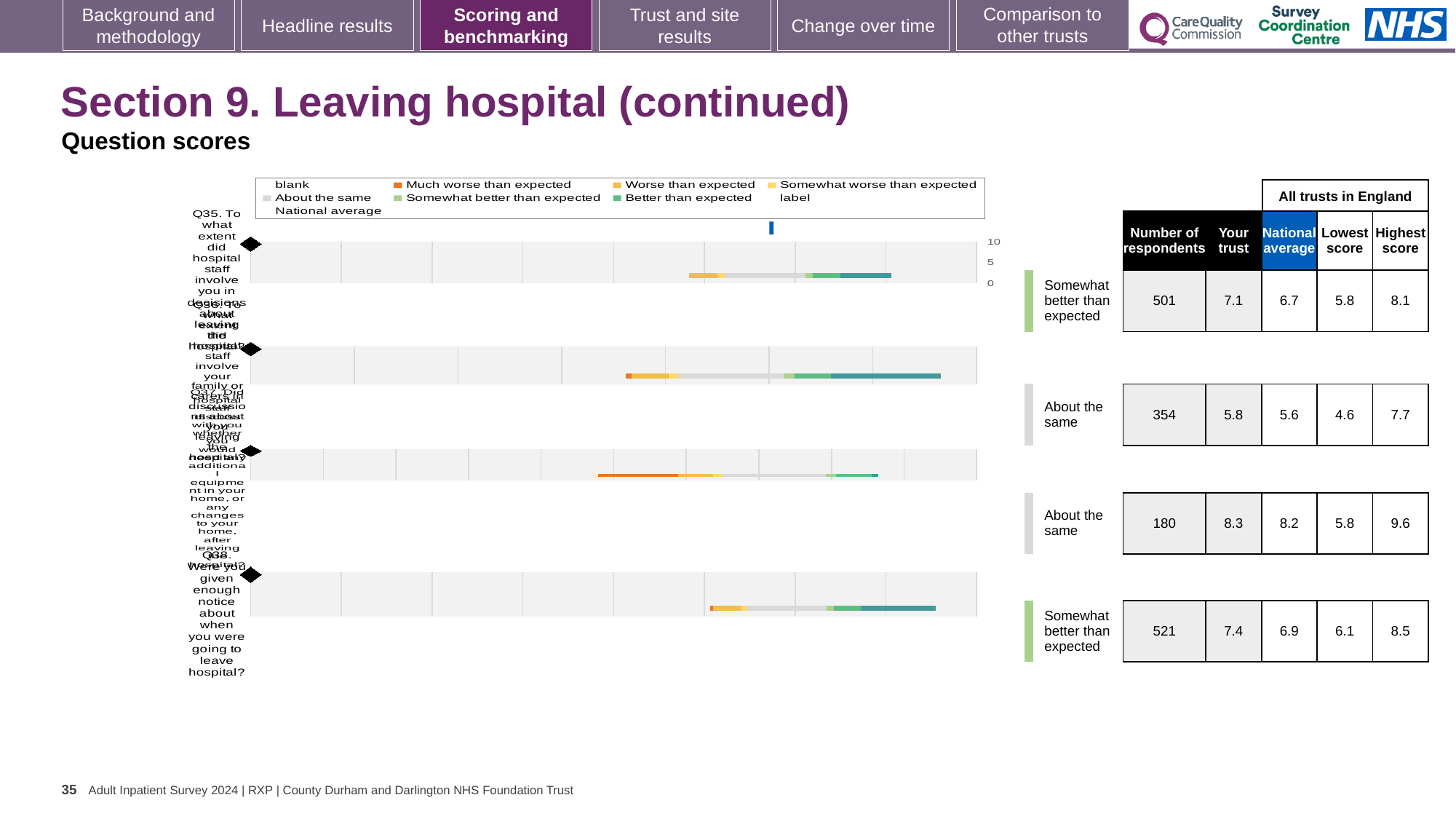
What is the difference between the highest score and the lowest score for Q35? 2.3 What is the highest score among all trusts in England for the second row (Q36)? 7.7 How many respondents are listed for Q38 (Were you given enough notice about when you were going to leave hospital?)? 521 How many survey questions (rows) are plotted in the chart? 4 For Q35, which is larger: the 'Your trust' score or the national average? Your trust (7.1) What benchmark category is shown for Q38? Somewhat better than expected What kind of chart is used to show the question scores on this slide? bar chart For Q38, how much higher is the 'Your trust' score than the national average? 0.5 What is the 'Your trust' score for Q35 (To what extent did hospital staff involve you in decisions about leaving the hospital?)? 7.1 What heading groups the 'National average', 'Lowest score' and 'Highest score' columns in the table? All trusts in England Which row has the highest 'Your trust' score, and what is it? The third row, 8.3 What is the lowest number of respondents shown in the table? 180